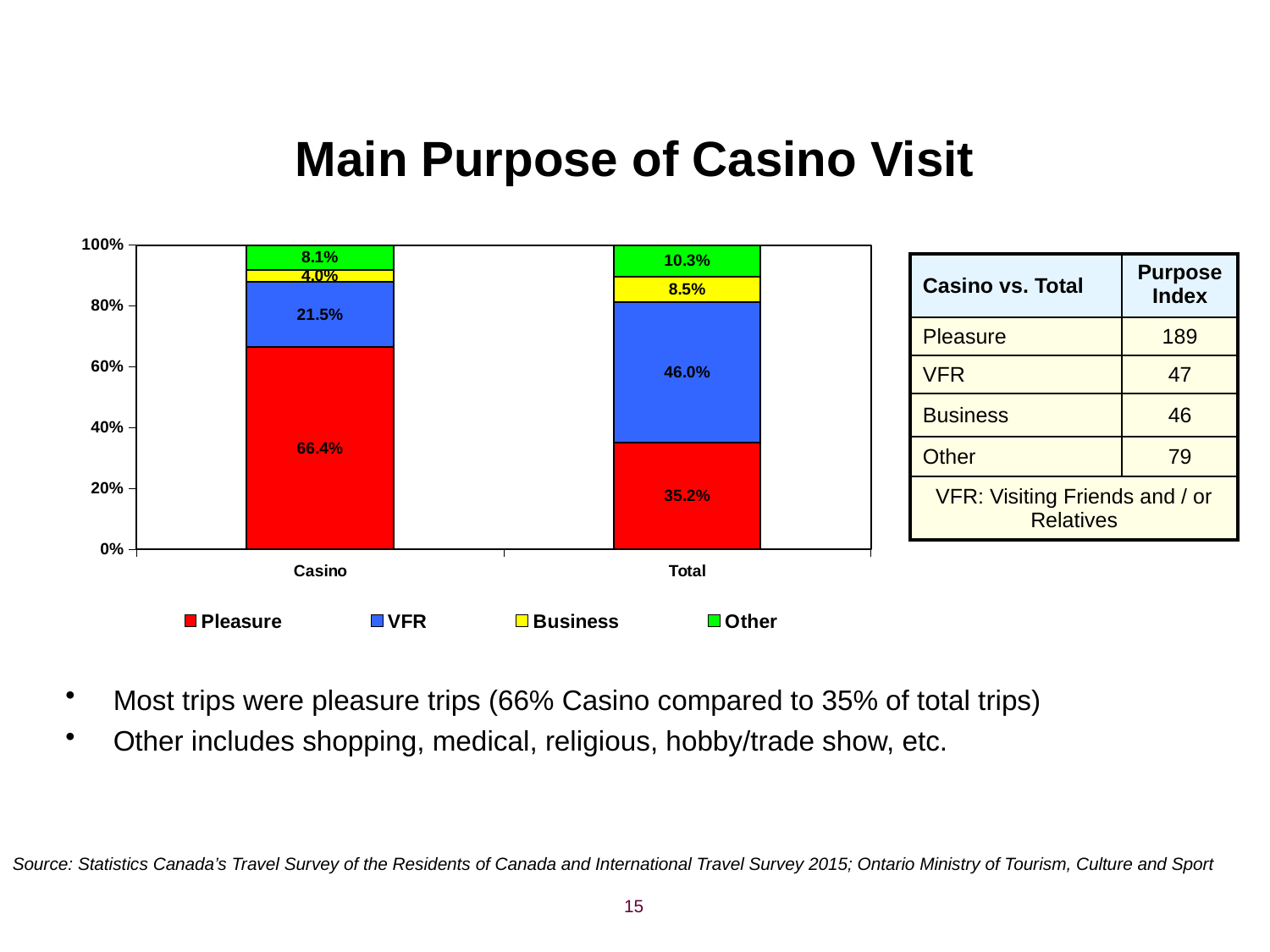
What colour represents Pleasure in the chart? Red Which purpose has the smallest share of Casino trips? Business What is the difference between the Pleasure share for Casino and the Pleasure share for Total? 31.2% What is the Other share for the Total bar? 10.3% How many categories are shown on the x axis? 2 What percentage of Casino trips were for Pleasure? 66.4% How many series does the legend list? 4 Which purpose has the largest share of Casino trips? Pleasure What is the Business share for the Casino bar? 4.0% What kind of chart is shown? Stacked bar chart Which is larger: the VFR share for Casino or the VFR share for Total? Total What percentage of Total trips were for VFR? 46.0%